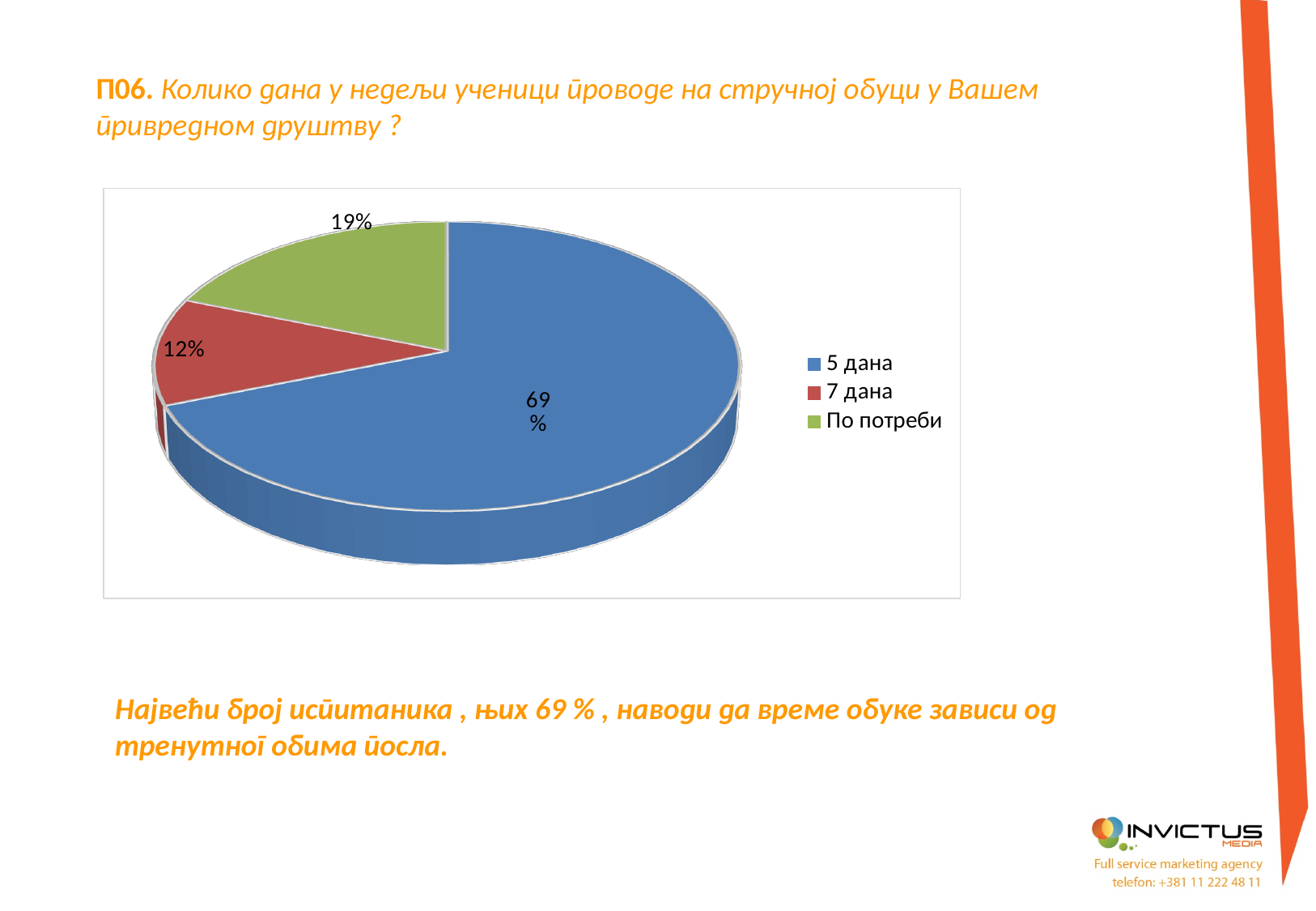
What is the difference in percentage points between the "5 дана" and "По потреби" slices? 50 What colour is the "5 дана" slice in the pie chart? Blue How many categories are shown in the pie chart? 3 Which category has the largest slice of the pie? 5 дана What share of the pie does the "По потреби" slice represent? 19% Which slice is larger, "7 дана" or "По потреби"? По потреби What kind of chart is shown on the slide? Pie chart Which category has the smallest slice of the pie? 7 дана What share of the pie does the "7 дана" slice represent? 12% What is the difference in percentage points between the "По потреби" and "7 дана" slices? 7 What share of the pie does the "5 дана" slice represent? 69% Which legend entry is shown in green? По потреби